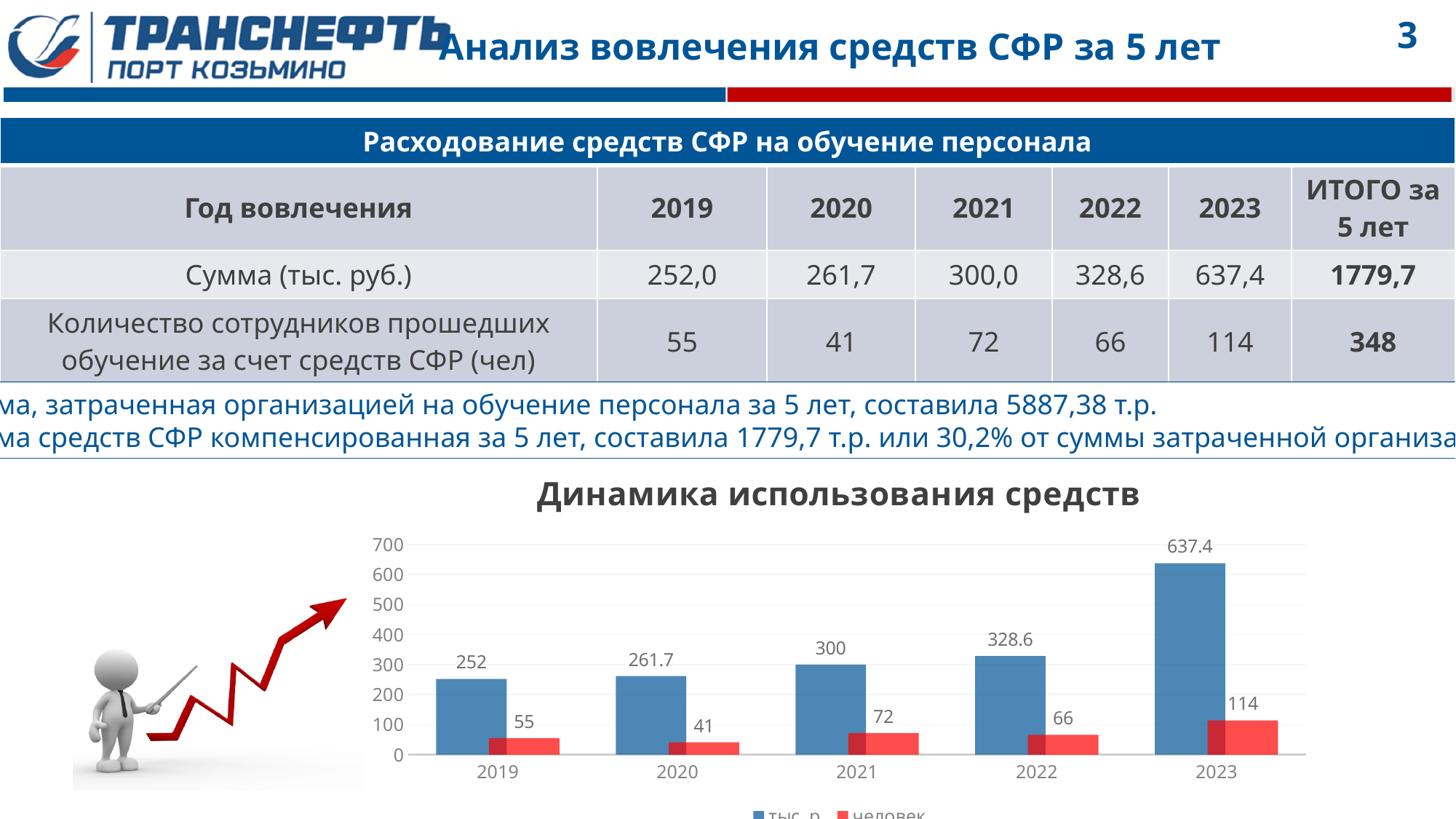
In the chart "Динамика использования средств", do the тыс. р. values rise or fall from 2019 to 2023? rise What is the title of the chart on the slide? Динамика использования средств In the chart "Динамика использования средств", which year has the highest value for тыс. р.? 2023 In the chart "Динамика использования средств", what is the value of the blue bar (тыс. р.) for 2020? 261.7 What type of chart is shown under the title "Динамика использования средств"? bar chart In the chart "Динамика использования средств", which is larger: the человек value for 2019 or for 2022? 2022 How many years are shown on the x axis of the chart "Динамика использования средств"? 5 In the chart "Динамика использования средств", what is the value of the red bar (человек) for 2021? 72 In the chart "Динамика использования средств", which year has the lowest value for человек? 2020 How many series does the legend of the chart "Динамика использования средств" list? 2 In the chart "Динамика использования средств", what is the difference between the тыс. р. values for 2023 and 2022? 308.8 In the chart "Динамика использования средств", what is the value of the blue bar (тыс. р.) for 2023? 637.4